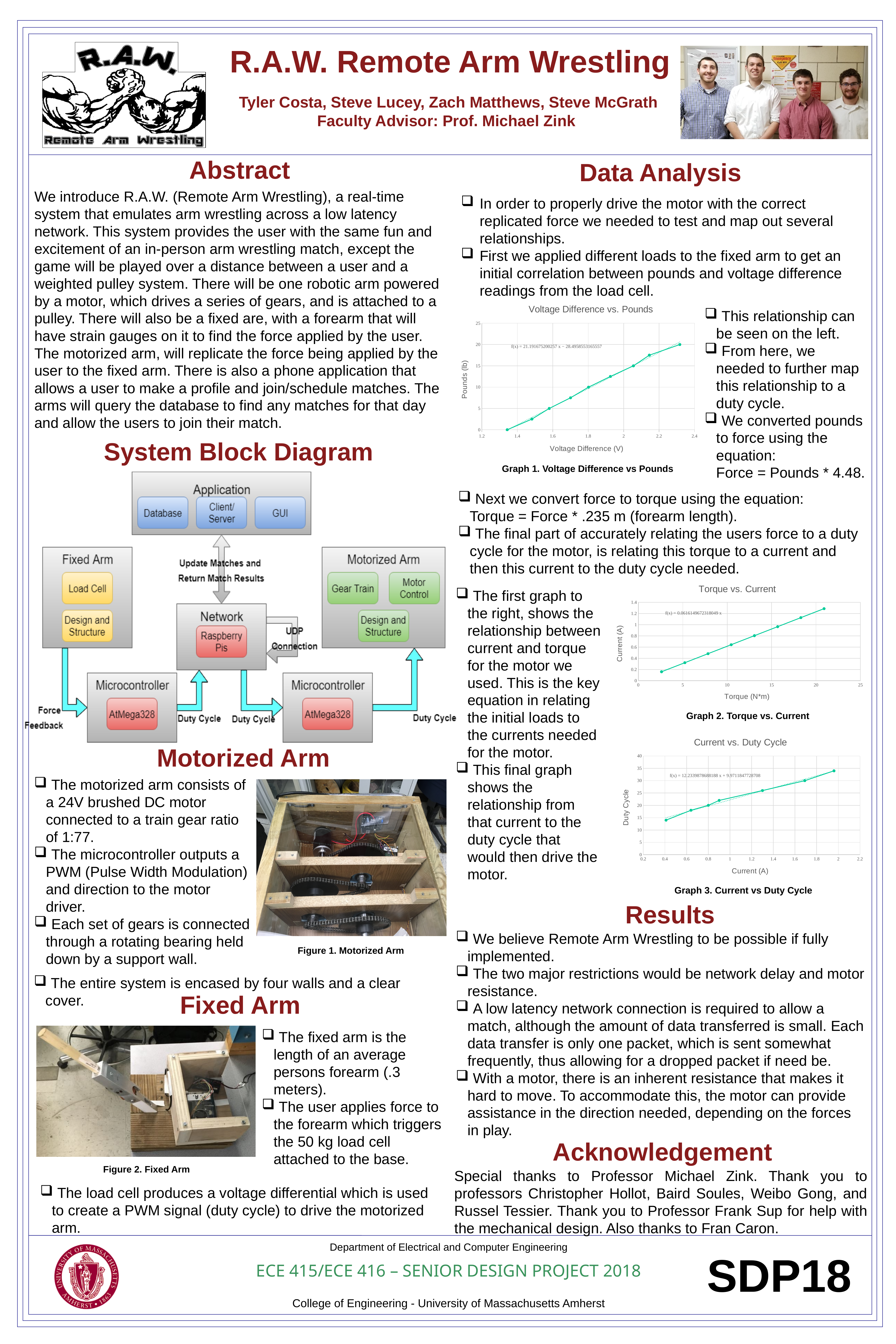
In "Voltage Difference vs. Pounds" (Graph 1), is the highest plotted pounds value greater or less than 15? greater In "Current vs. Duty Cycle" (Graph 3), is the highest plotted duty cycle value greater or less than 30? greater In "Current vs. Duty Cycle" (Graph 3), do the duty cycle values rise or fall as current increases? rise In "Torque vs. Current" (Graph 2), do the current values rise or fall as torque increases? rise In "Torque vs. Current" (Graph 2), is the lowest plotted current value greater or less than 0.4? less What is the x-axis label of "Voltage Difference vs. Pounds" (Graph 1)? Voltage Difference (V) What kind of chart is "Voltage Difference vs. Pounds" (Graph 1)? line chart What is the y-axis label of "Torque vs. Current" (Graph 2)? Current (A) What kind of chart is "Current vs. Duty Cycle" (Graph 3)? line chart In "Voltage Difference vs. Pounds" (Graph 1), do the pounds values rise or fall as voltage difference increases? rise